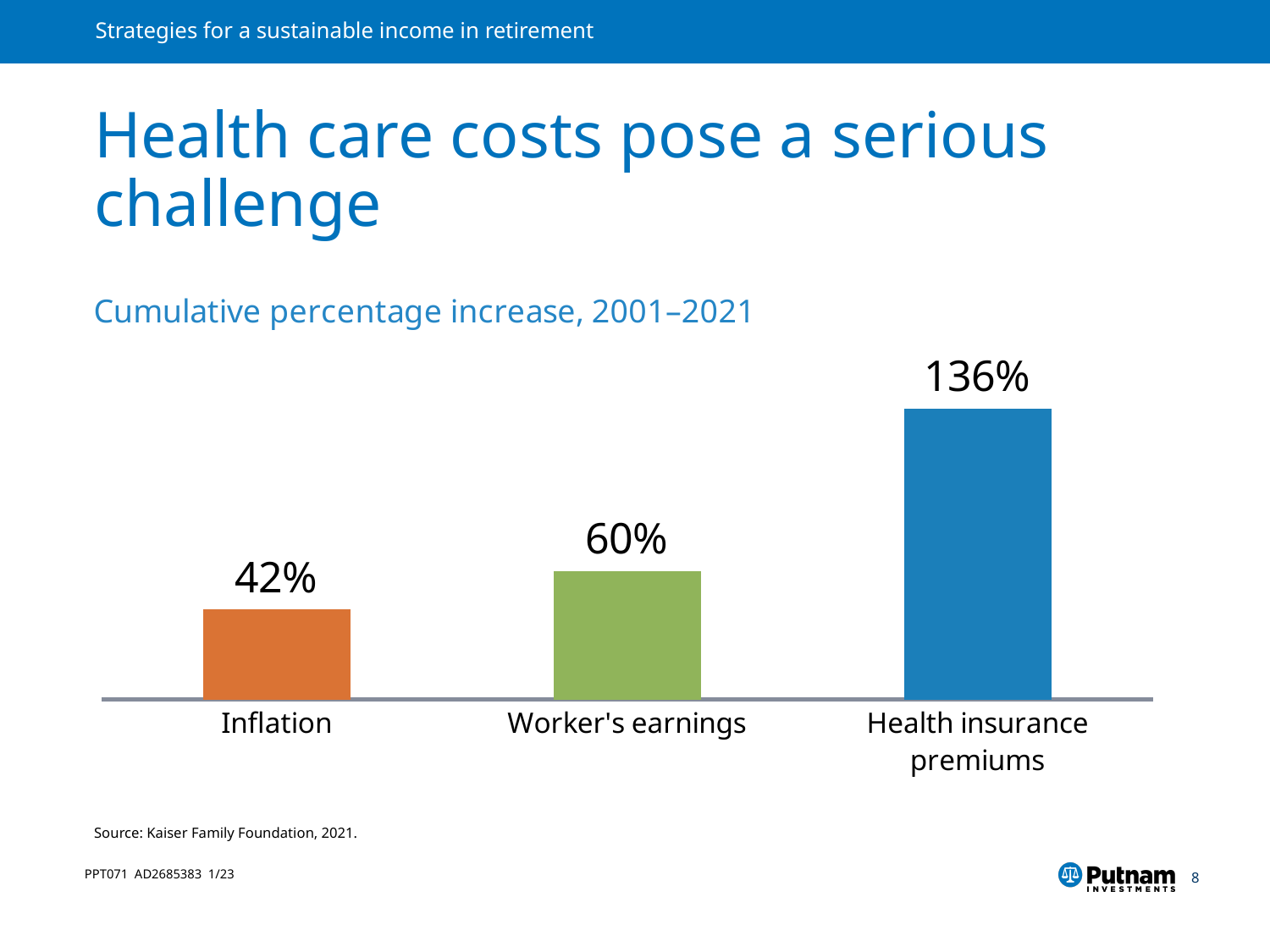
What kind of chart is shown on the slide? Bar chart What is the difference between the increase for Worker's earnings and the increase for Inflation? 18% What is the cumulative percentage increase for Inflation? 42% Which category has the lowest cumulative percentage increase? Inflation What is the cumulative percentage increase for Health insurance premiums? 136% What is the cumulative percentage increase for Worker's earnings? 60% What is the difference between the increase for Health insurance premiums and the increase for Inflation? 94% What period does the chart's subtitle say the cumulative percentage increase covers? 2001–2021 Which is larger, the increase for Worker's earnings or the increase for Inflation? Worker's earnings Do the values rise or fall from left to right across the categories? Rise Which category has the highest cumulative percentage increase? Health insurance premiums How many categories are shown in the chart? 3